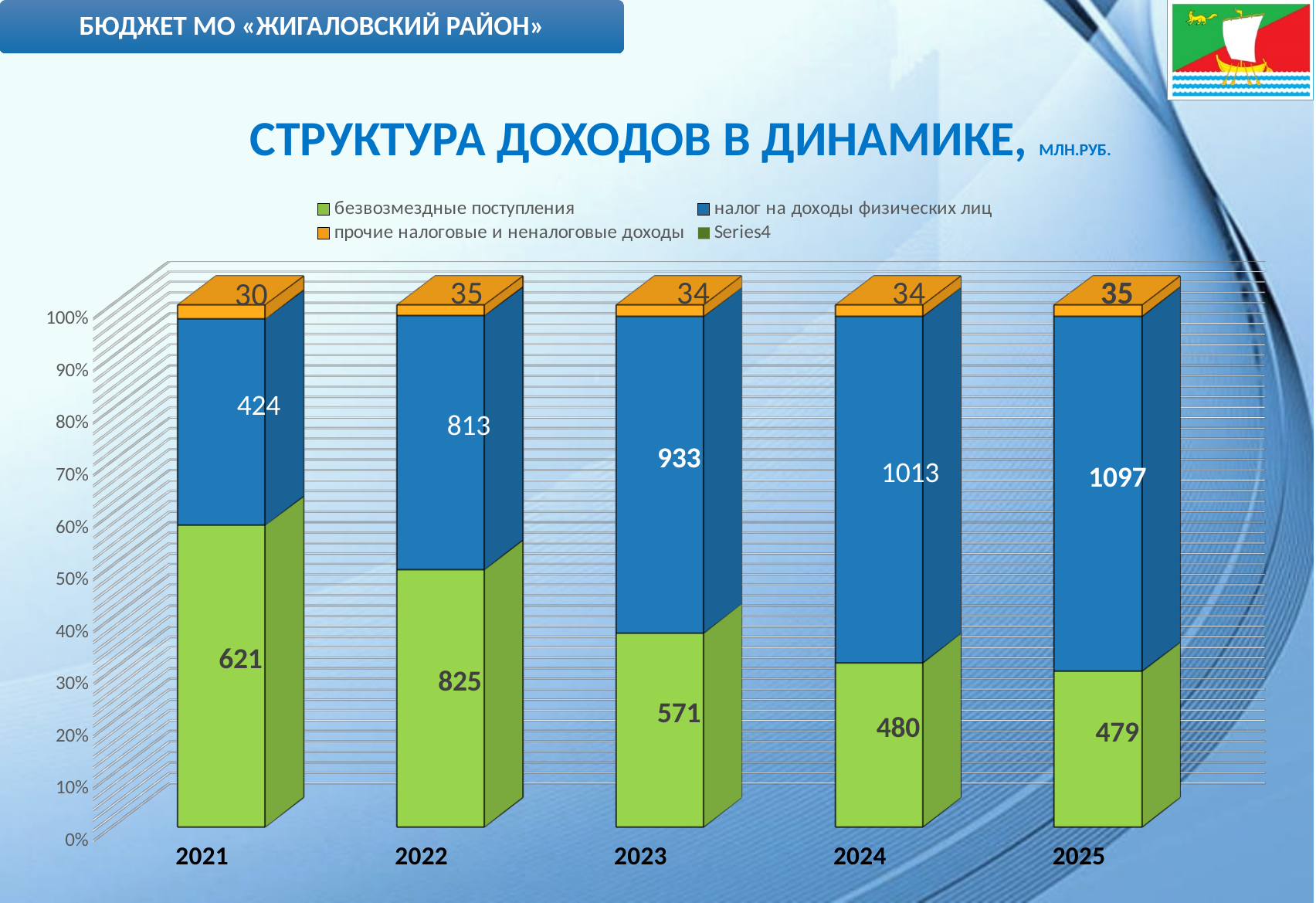
In which year is безвозмездные поступления lowest? 2025 What kind of chart is shown on the slide? stacked bar chart In which year is налог на доходы физических лиц highest? 2025 What is the value for прочие налоговые и неналоговые доходы in 2021? 30 What is the value for налог на доходы физических лиц in 2023? 933 What is the difference between налог на доходы физических лиц in 2025 and in 2021? 673 Does the value for налог на доходы физических лиц rise or fall from 2021 to 2025? rise Which is larger in 2022: безвозмездные поступления or налог на доходы физических лиц? безвозмездные поступления What is the total of the three labelled values in the 2024 bar? 1527 How many years are shown on the x axis? 5 What is the value for безвозмездные поступления in 2022? 825 How many entries does the legend list? 4